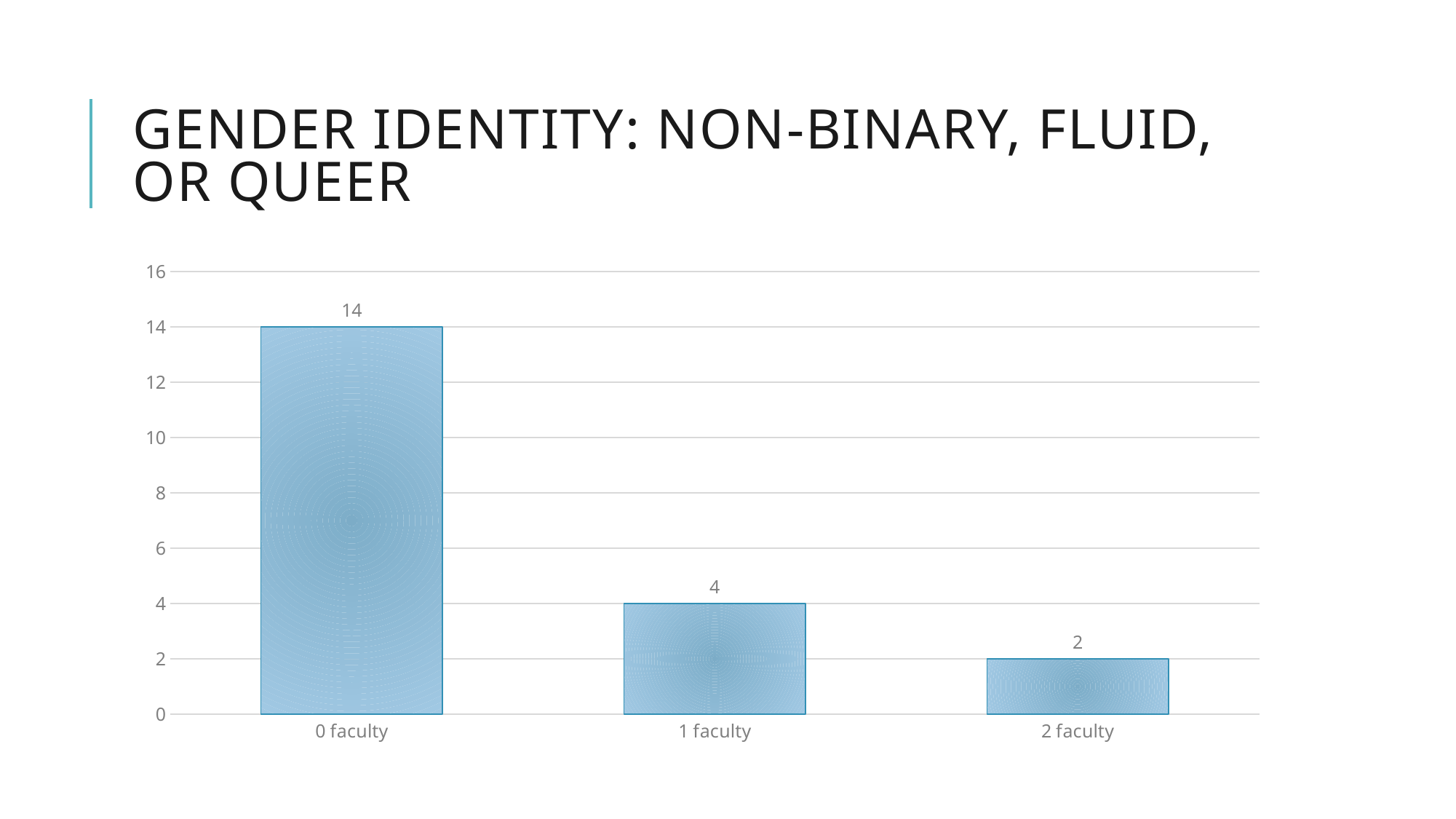
What is the difference between the values for "0 faculty" and "1 faculty"? 10 Which is larger, the value for "1 faculty" or the value for "2 faculty"? 1 faculty How many categories are shown on the x axis? 3 What is the value for the "1 faculty" category? 4 Is the value for "0 faculty" greater or less than 10? greater Which category has the lowest value? 2 faculty What is the value for the "2 faculty" category? 2 What kind of chart is shown on the slide? bar chart Which category has the highest value? 0 faculty What is the difference between the values for "1 faculty" and "2 faculty"? 2 What is the value for the "0 faculty" category? 14 Do the values rise or fall from left to right along the x axis? fall